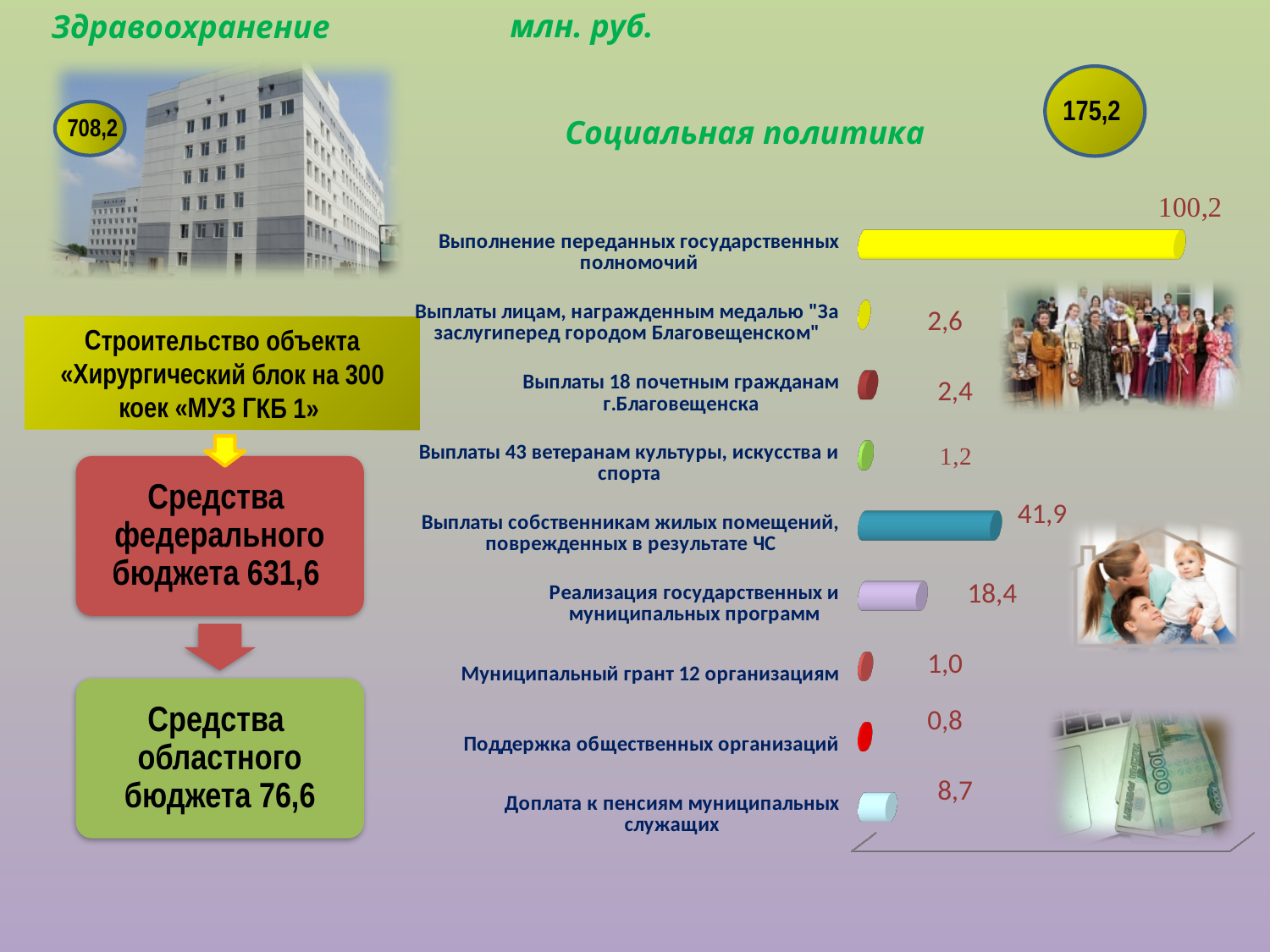
Which category has the lowest value in the «Социальная политика» chart? Поддержка общественных организаций What is the value for «Доплата к пенсиям муниципальных служащих»? 8,7 What is the value for «Выплаты 18 почетным гражданам г.Благовещенска»? 2,4 What is the value for «Выплаты собственникам жилых помещений, поврежденных в результате ЧС»? 41,9 What is the value for «Реализация государственных и муниципальных программ»? 18,4 What is the value for «Выполнение переданных государственных полномочий»? 100,2 Which category has the highest value in the «Социальная политика» chart? Выполнение переданных государственных полномочий What is the difference between the values for «Выплаты собственникам жилых помещений, поврежденных в результате ЧС» and «Реализация государственных и муниципальных программ»? 23,5 How many categories does the «Социальная политика» bar chart show? 9 Which is larger: the value for «Выплаты лицам, награжденным медалью» or the value for «Выплаты 43 ветеранам культуры, искусства и спорта»? Выплаты лицам, награжденным медалью What is the difference between the values for «Муниципальный грант 12 организациям» and «Поддержка общественных организаций»? 0,2 What kind of chart is shown under the heading «Социальная политика»? bar chart